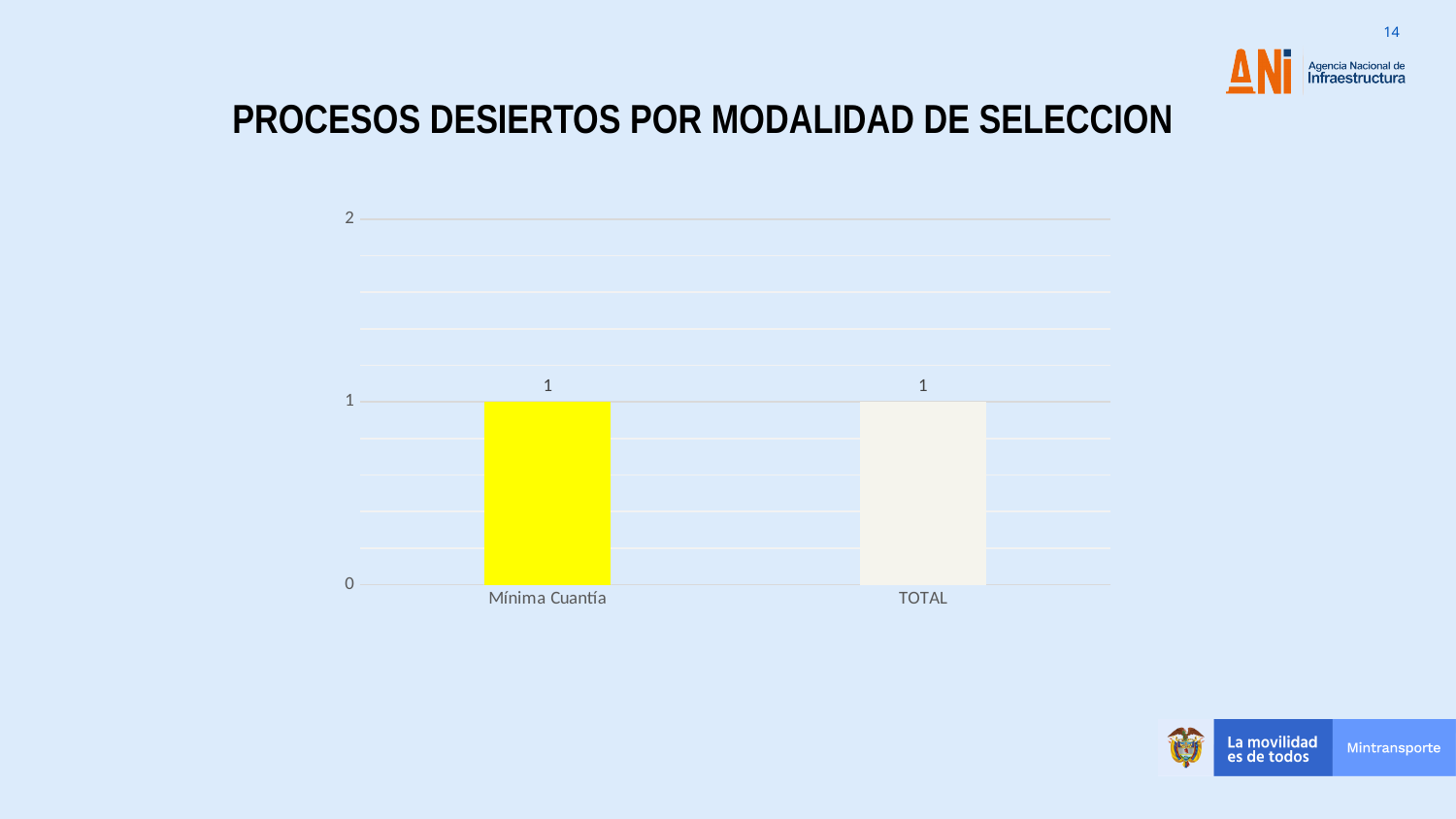
What colour is the bar for Mínima Cuantía? yellow Is the value for TOTAL greater or less than 2? less Is the value for Mínima Cuantía greater or less than 2? less What is the value for Mínima Cuantía? 1 What is the highest value shown on the y axis? 2 How many categories are shown on the x axis? 2 What is the value for TOTAL? 1 What is the title of the chart? PROCESOS DESIERTOS POR MODALIDAD DE SELECCION What kind of chart is shown on the slide? bar chart What is the difference between the values for Mínima Cuantía and TOTAL? 0